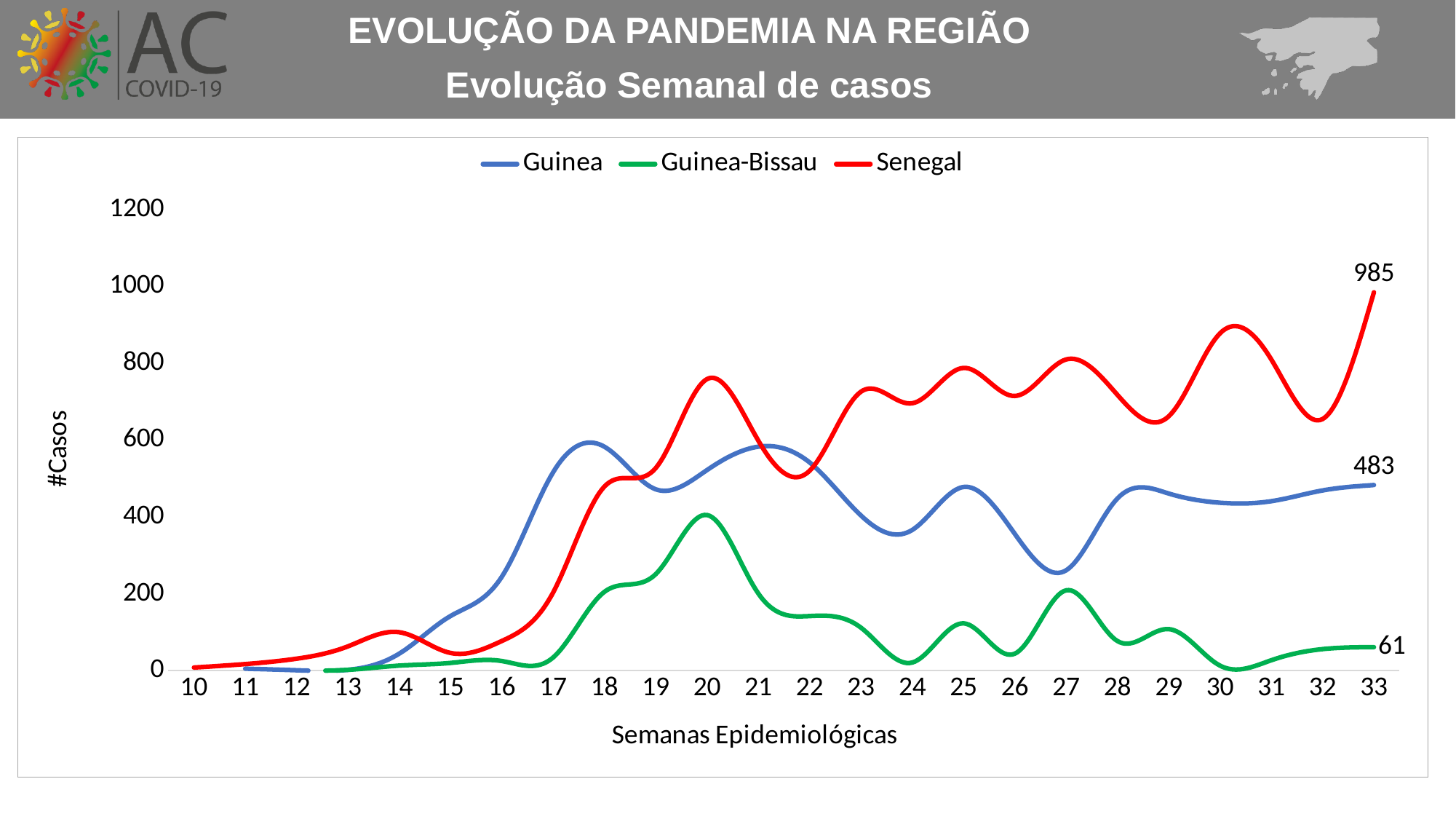
Which series has the lowest value at week 33? Guinea-Bissau What is the value for Guinea-Bissau at week 33? 61 What is the difference between the Guinea and Guinea-Bissau values at week 33? 422 How many series does the legend list? 3 Is the value for Senegal at week 20 greater or less than 600? greater What is the label of the y axis? #Casos What kind of chart is shown on the slide? line chart Which series has the highest value at week 33? Senegal What is the difference between the Senegal and Guinea values at week 33? 502 What is the value for Guinea at week 33? 483 Is the value for Guinea at week 27 greater or less than 400? less What is the value for Senegal at week 33? 985